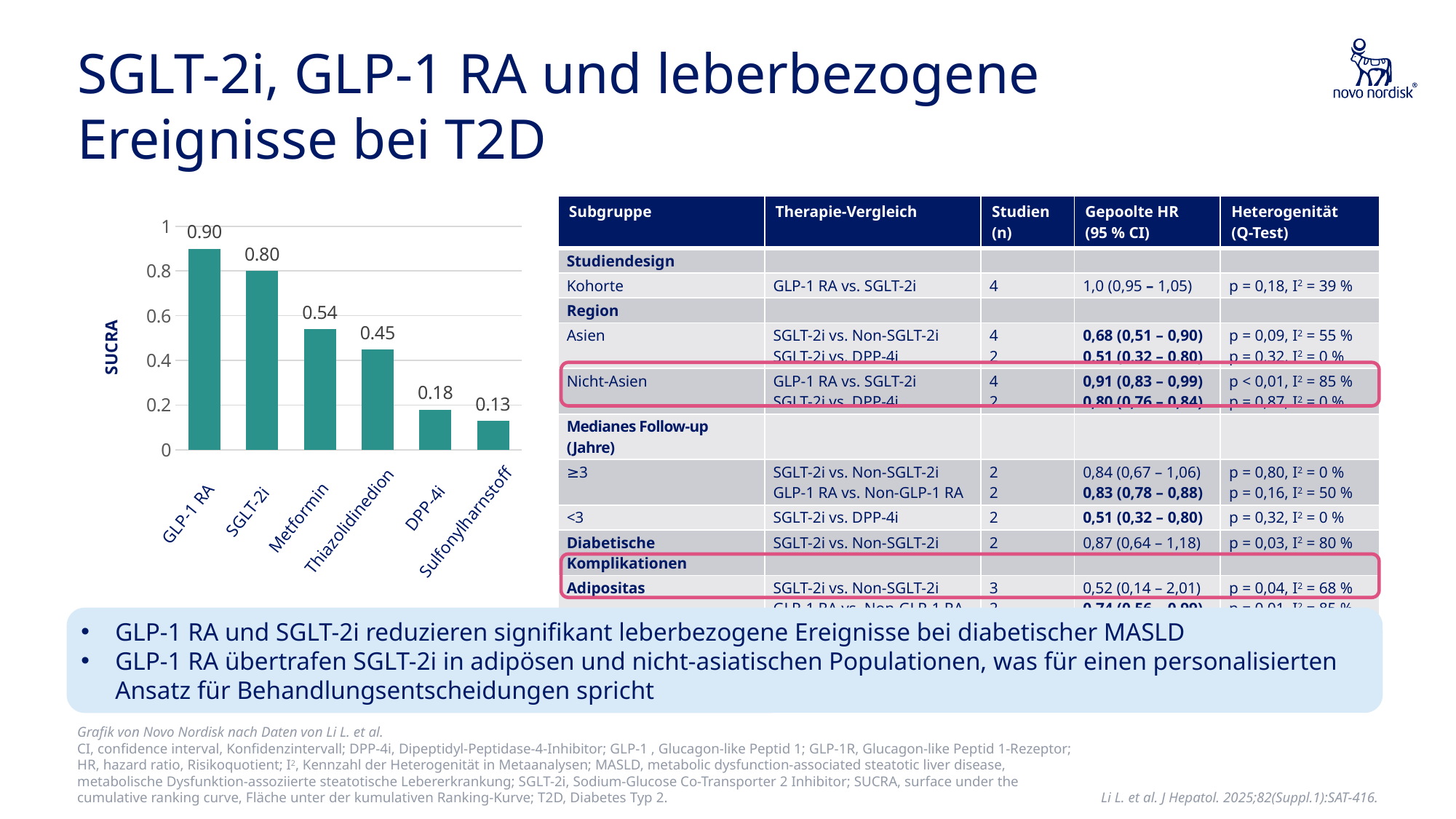
Which has a higher SUCRA value, Thiazolidinedion or DPP-4i? Thiazolidinedion Which category has the highest SUCRA value? GLP-1 RA What is the label of the y axis of the chart? SUCRA What is the SUCRA value for GLP-1 RA? 0.90 Is the SUCRA value for DPP-4i greater or less than 0.2? less What kind of chart is shown on the slide? bar chart Which category has the lowest SUCRA value? Sulfonylharnstoff How many categories are shown in the bar chart? 6 What is the SUCRA value for Metformin? 0.54 What is the SUCRA value for Sulfonylharnstoff? 0.13 What is the difference between the SUCRA values of Metformin and Thiazolidinedion? 0.09 What is the difference between the SUCRA values of GLP-1 RA and SGLT-2i? 0.10